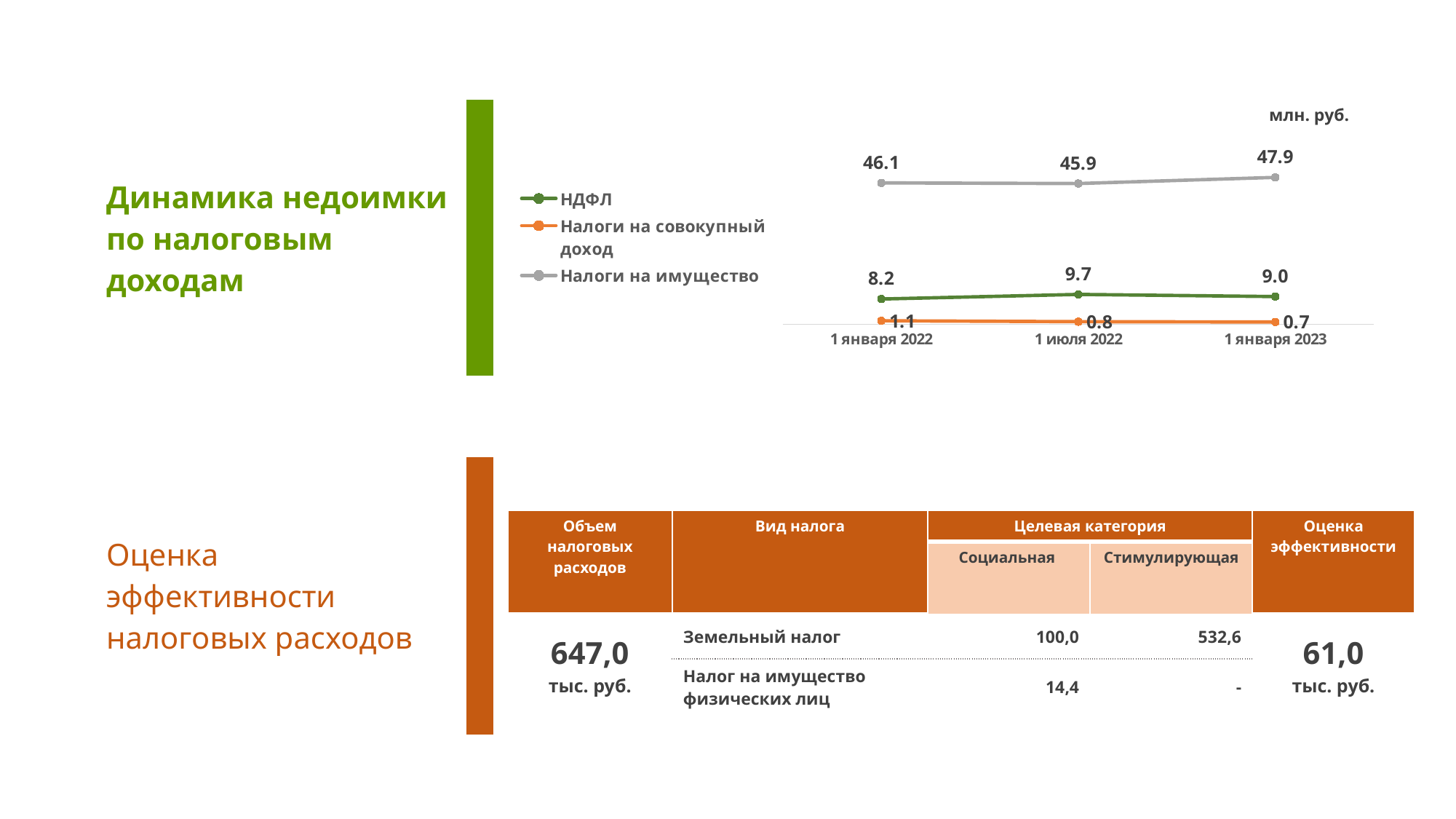
What is the value for Налоги на совокупный доход on 1 января 2022? 1.1 On which date is the value for Налоги на имущество the lowest? 1 июля 2022 What is the difference between the Налоги на имущество values on 1 января 2023 and 1 января 2022? 1.8 How many series does the chart legend list? 3 How many dates are plotted along the x axis of the chart? 3 What type of chart is shown on the slide? line chart What is the value for Налоги на имущество on 1 января 2023? 47.9 On which date is the value for НДФЛ the highest? 1 июля 2022 What is the value for НДФЛ on 1 июля 2022? 9.7 Do the values for Налоги на совокупный доход rise or fall from 1 января 2022 to 1 января 2023? fall Which series has the larger value on 1 января 2023: НДФЛ or Налоги на совокупный доход? НДФЛ What unit is indicated in the top right corner of the chart? млн. руб.